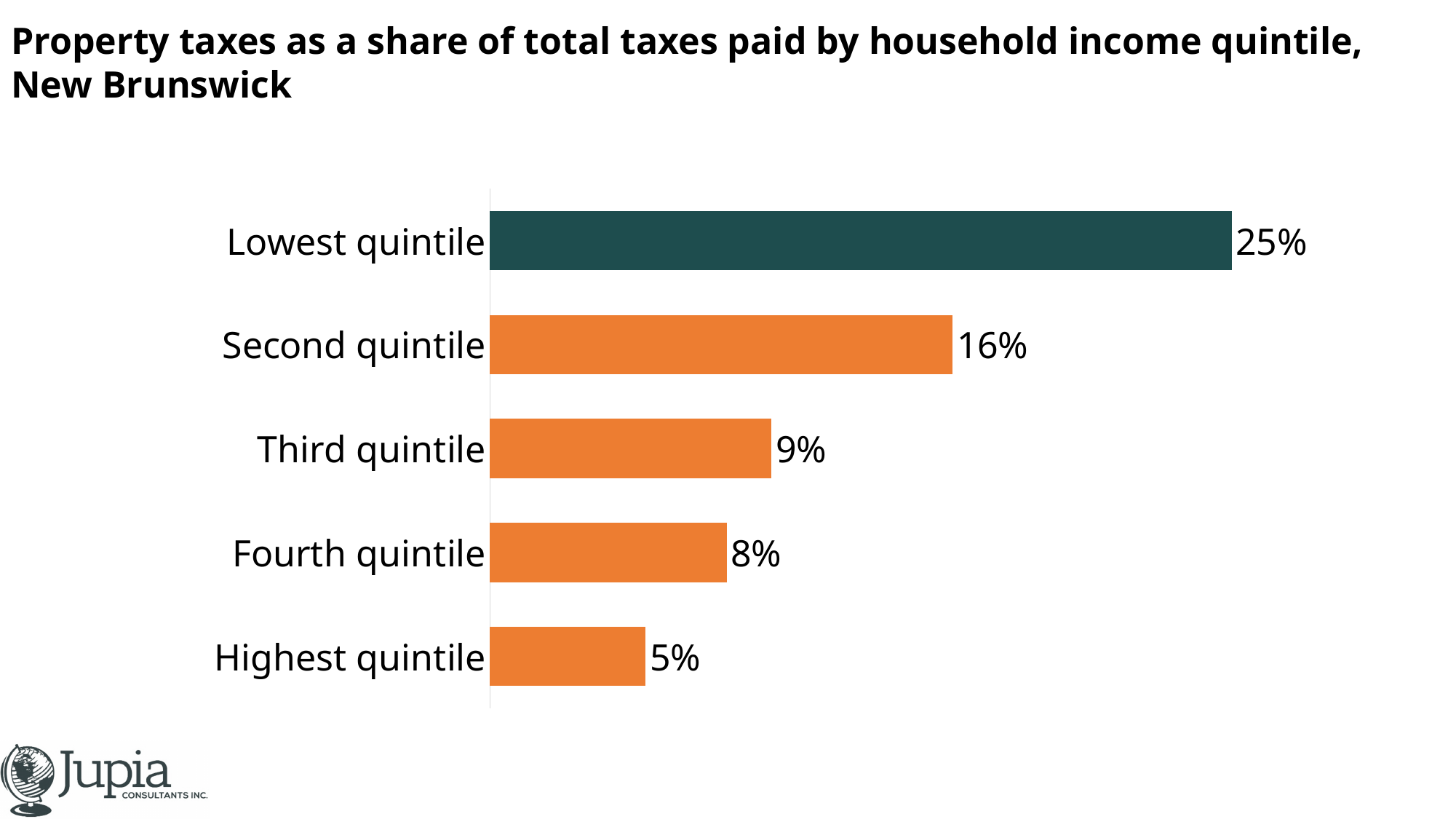
What is the value for the Second quintile? 16% Which quintile has the lowest property tax share? Highest quintile What is the value for the Lowest quintile? 25% Which is larger, the value for the Third quintile or the Fourth quintile? Third quintile What is the difference between the Second quintile and the Fourth quintile values? 8 percentage points What is the difference between the Lowest quintile and the Highest quintile values? 20 percentage points What is the value for the Third quintile? 9% Which bar is coloured differently from the others? Lowest quintile How many quintile categories are shown in the chart? 5 What is the value for the Highest quintile? 5% What kind of chart is shown on the slide? Bar chart Which quintile has the highest property tax share? Lowest quintile